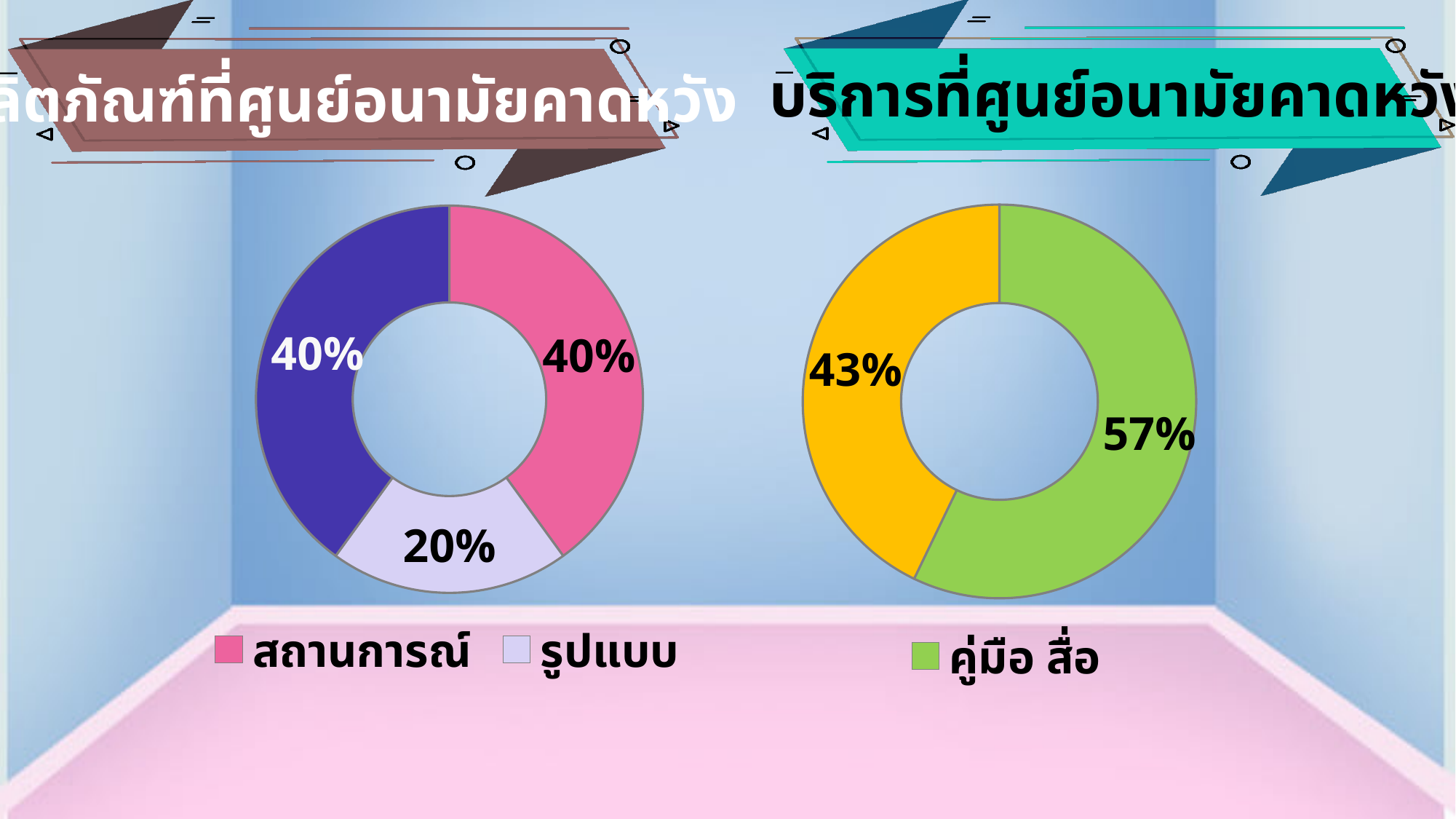
In the right chart titled บริการที่ศูนย์อนามัยคาดหวัง, what value is shown on the orange slice? 43% In the left chart, what colour is the slice for สถานการณ์? Pink How many slices does the left chart have? 3 In the left chart, what is the value shown for สถานการณ์? 40% How many slices does the right chart titled บริการที่ศูนย์อนามัยคาดหวัง have? 2 In the right chart titled บริการที่ศูนย์อนามัยคาดหวัง, what is the value shown for คู่มือ สื่อ? 57% In the left chart, which is larger, สถานการณ์ or รูปแบบ? สถานการณ์ In the right chart titled บริการที่ศูนย์อนามัยคาดหวัง, what is the difference between the two slice values? 14 percentage points In the left chart, which labelled category has the smallest slice? รูปแบบ In the left chart, what is the difference between the values for สถานการณ์ and รูปแบบ? 20 percentage points What kind of chart is the left chart? Doughnut (pie) chart In the left chart, what is the value shown for รูปแบบ? 20%